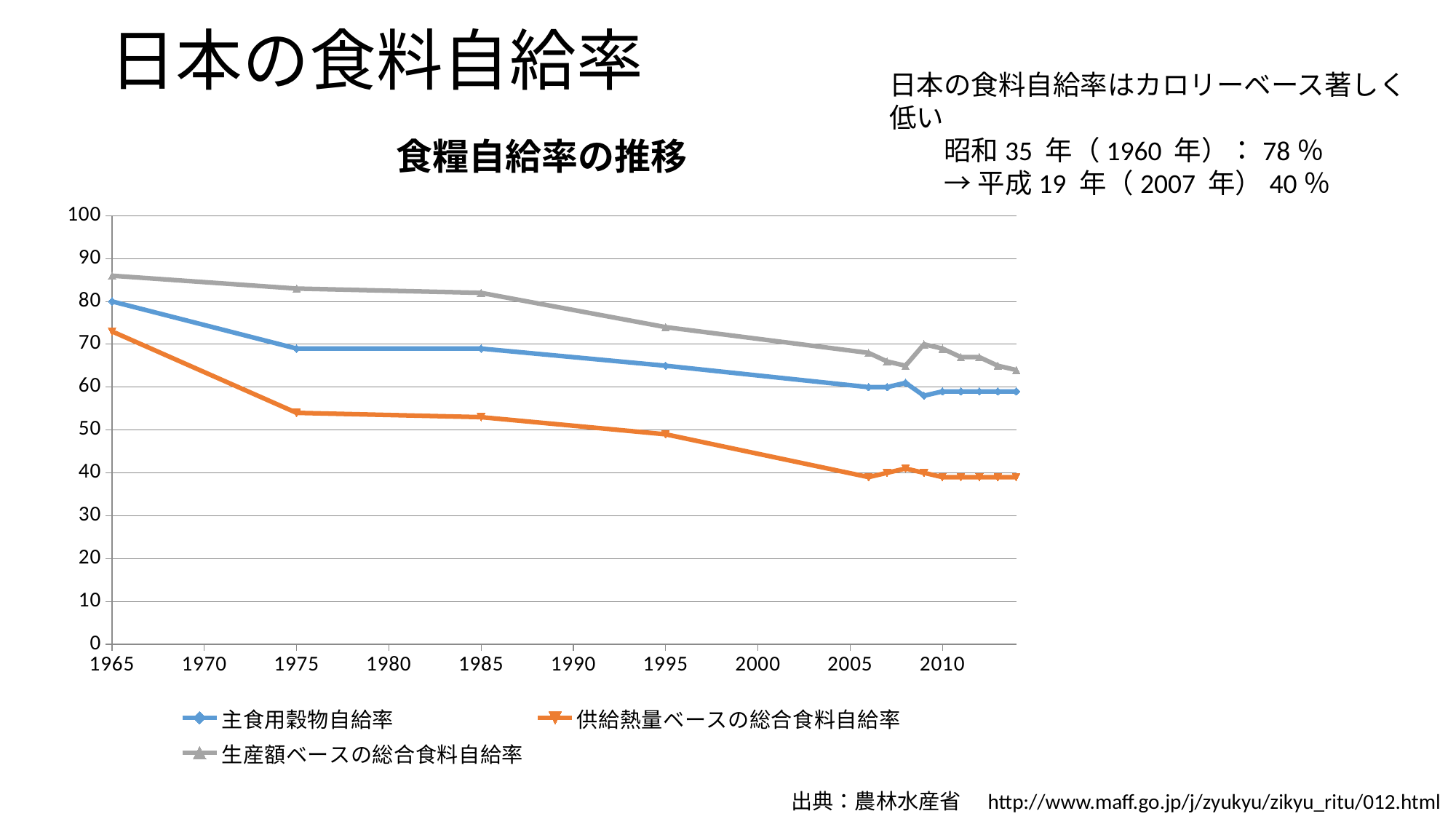
Which series is plotted in orange? 供給熱量ベースの総合食料自給率 What kind of chart is shown on the slide? line chart Is the value for 生産額ベースの総合食料自給率 in 1965 greater or less than 80? greater What is the title of the chart? 食糧自給率の推移 Does the 供給熱量ベースの総合食料自給率 series generally rise or fall from 1965 to 2010? fall Is the value for 供給熱量ベースの総合食料自給率 in 1965 greater or less than 70? greater How many series does the legend list? 3 Is the value for 主食用穀物自給率 in 1995 greater or less than 60? greater Which series has the highest value in 1985? 生産額ベースの総合食料自給率